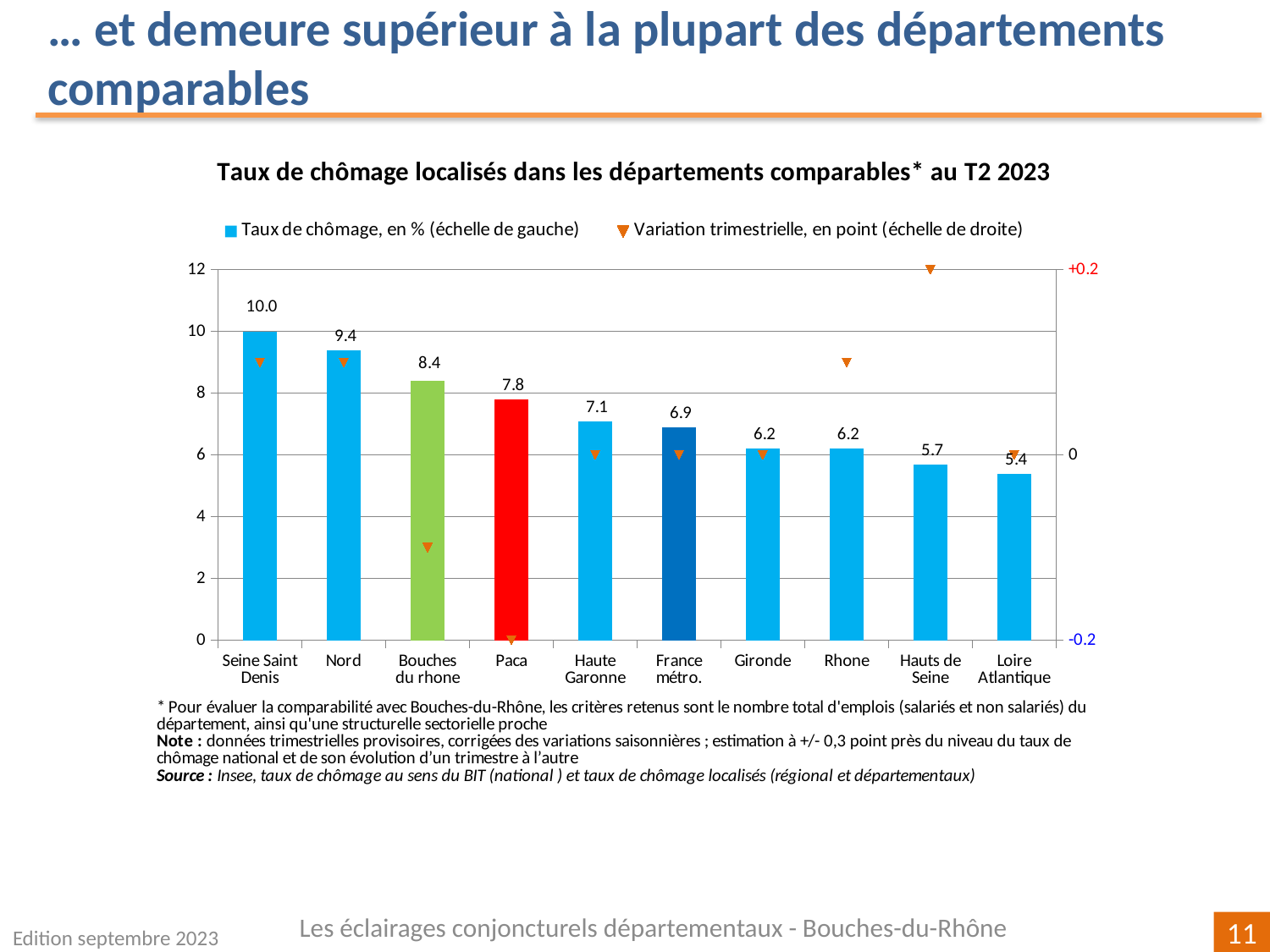
Is the quarterly variation (right axis) for Bouches du rhone greater or less than 0? less Which department has the lowest unemployment rate on the chart? Loire Atlantique What is the unemployment rate shown for Bouches du rhone? 8.4 How many departments or areas are shown on the x axis? 10 Is the quarterly variation (right axis) for Rhone greater or less than 0? greater How many series does the legend list? 2 Which department has the highest unemployment rate on the chart? Seine Saint Denis What is the difference between the unemployment rates of Bouches du rhone and Paca? 0.6 What is the unemployment rate shown for Seine Saint Denis? 10.0 Do the unemployment rate bars rise or fall from left to right along the x axis? fall What is the unemployment rate shown for France métro.? 6.9 Which has a higher unemployment rate, Nord or Haute Garonne? Nord